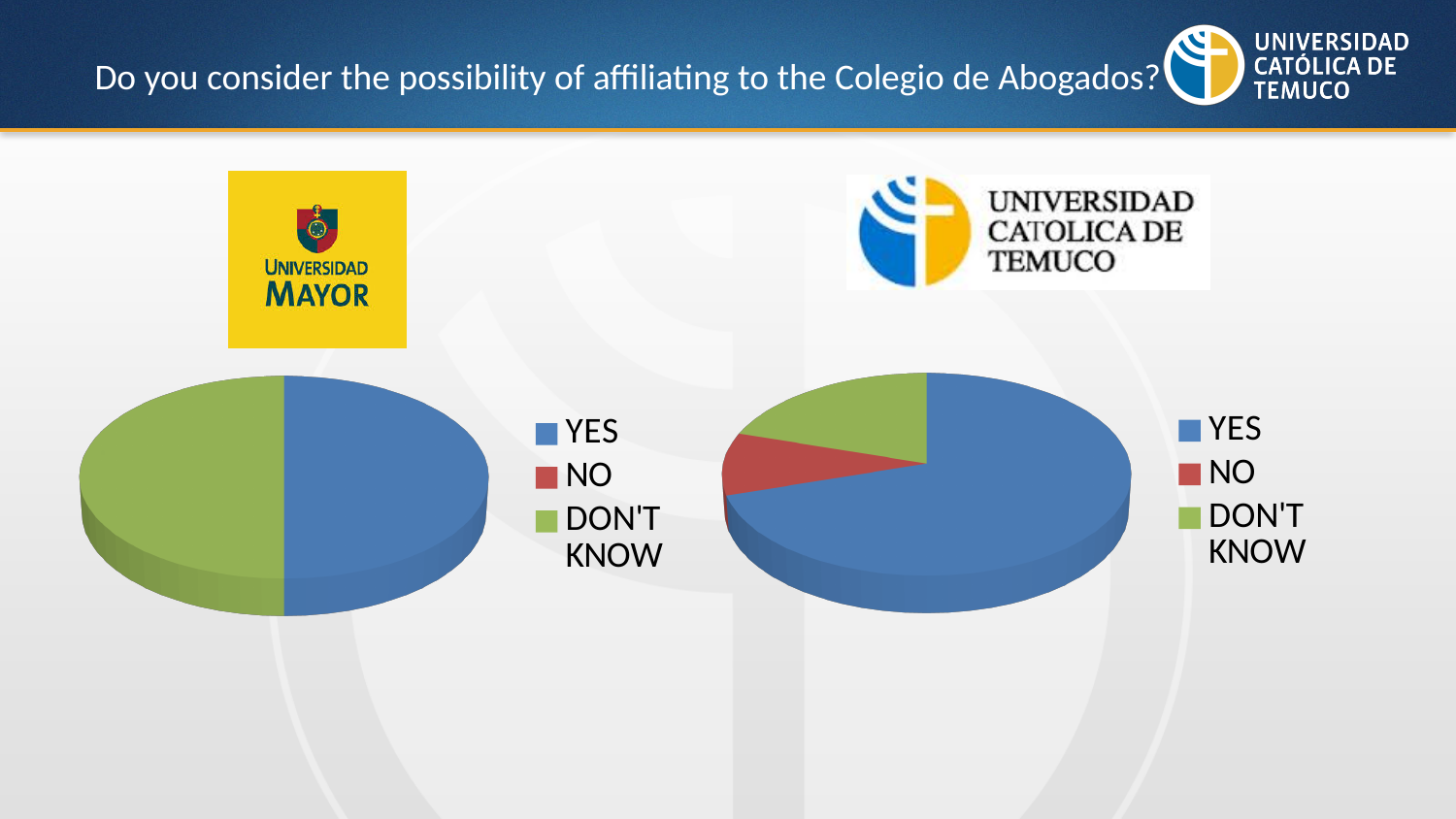
What kind of chart is shown on the right side of the slide? pie chart In the right pie chart (Universidad Católica de Temuco), which slice is larger, YES or NO? YES How many entries does the legend of the right pie chart list? 3 How many entries does the legend of the left pie chart list? 3 In the left pie chart (Universidad Mayor), which slice is larger, YES or NO? YES In the right pie chart (Universidad Católica de Temuco), which response has the largest slice? YES What kind of chart is shown on the left side of the slide? pie chart In the right pie chart (Universidad Católica de Temuco), which slice is larger, DON'T KNOW or NO? DON'T KNOW What colour represents the DON'T KNOW response in the pie charts? green What colour represents the YES response in the pie charts? blue In the right pie chart (Universidad Católica de Temuco), which response has the smallest slice? NO How many pie charts are on the slide? 2